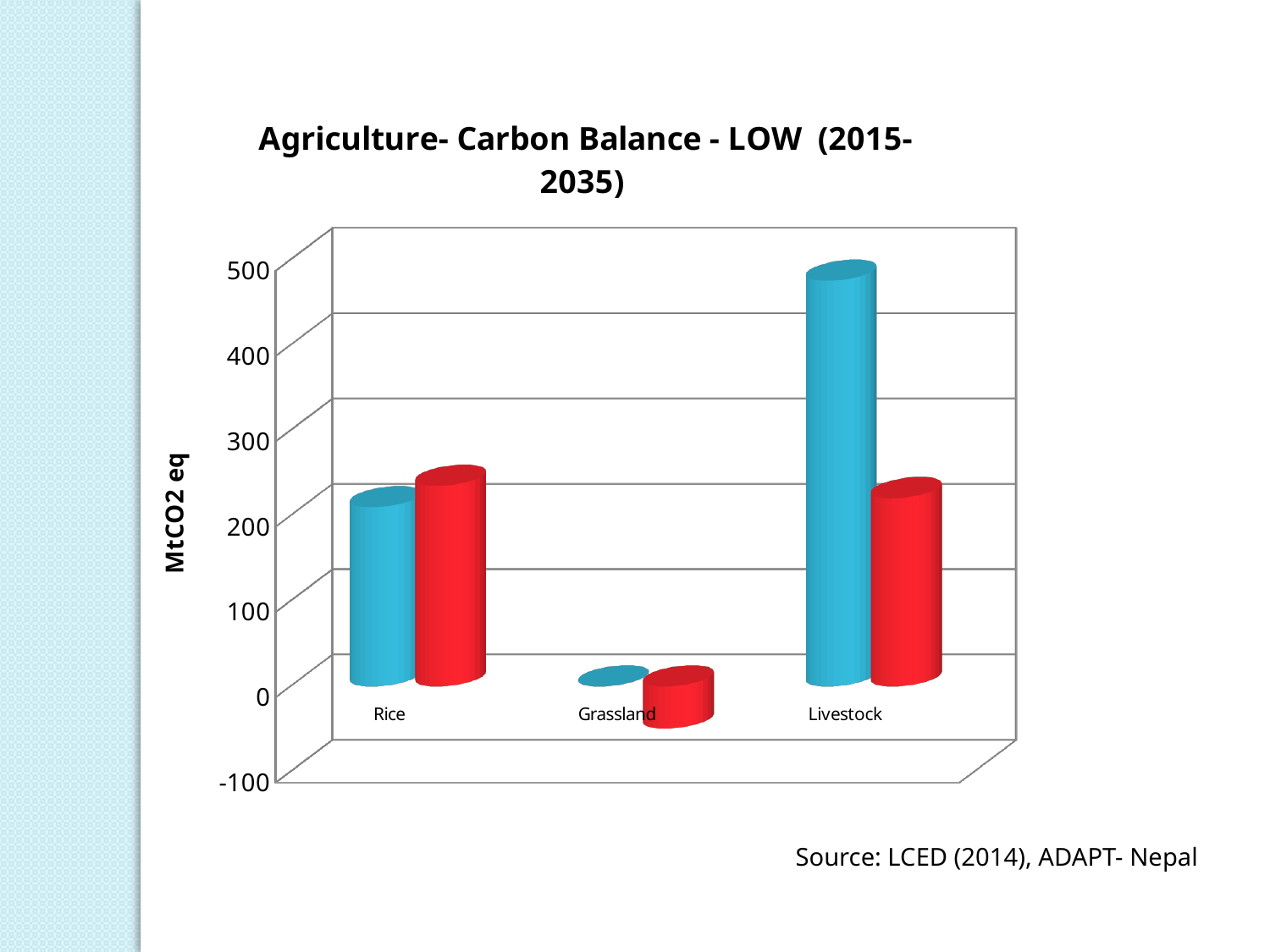
Is the red bar for Rice greater or less than 300? less Which is larger, the blue bar for Livestock or the blue bar for Rice? Livestock What kind of chart is shown on the slide? Bar chart Which category has the lowest blue bar? Grassland Which category has the tallest blue bar? Livestock What is the label on the vertical axis of the chart? MtCO2 eq Is the blue bar for Livestock greater or less than 400? greater Is the blue bar for Rice greater or less than 100? greater How many categories are shown on the x axis of the chart? 3 What is the title of the chart? Agriculture- Carbon Balance - LOW (2015-2035) Which category has the lowest red bar? Grassland